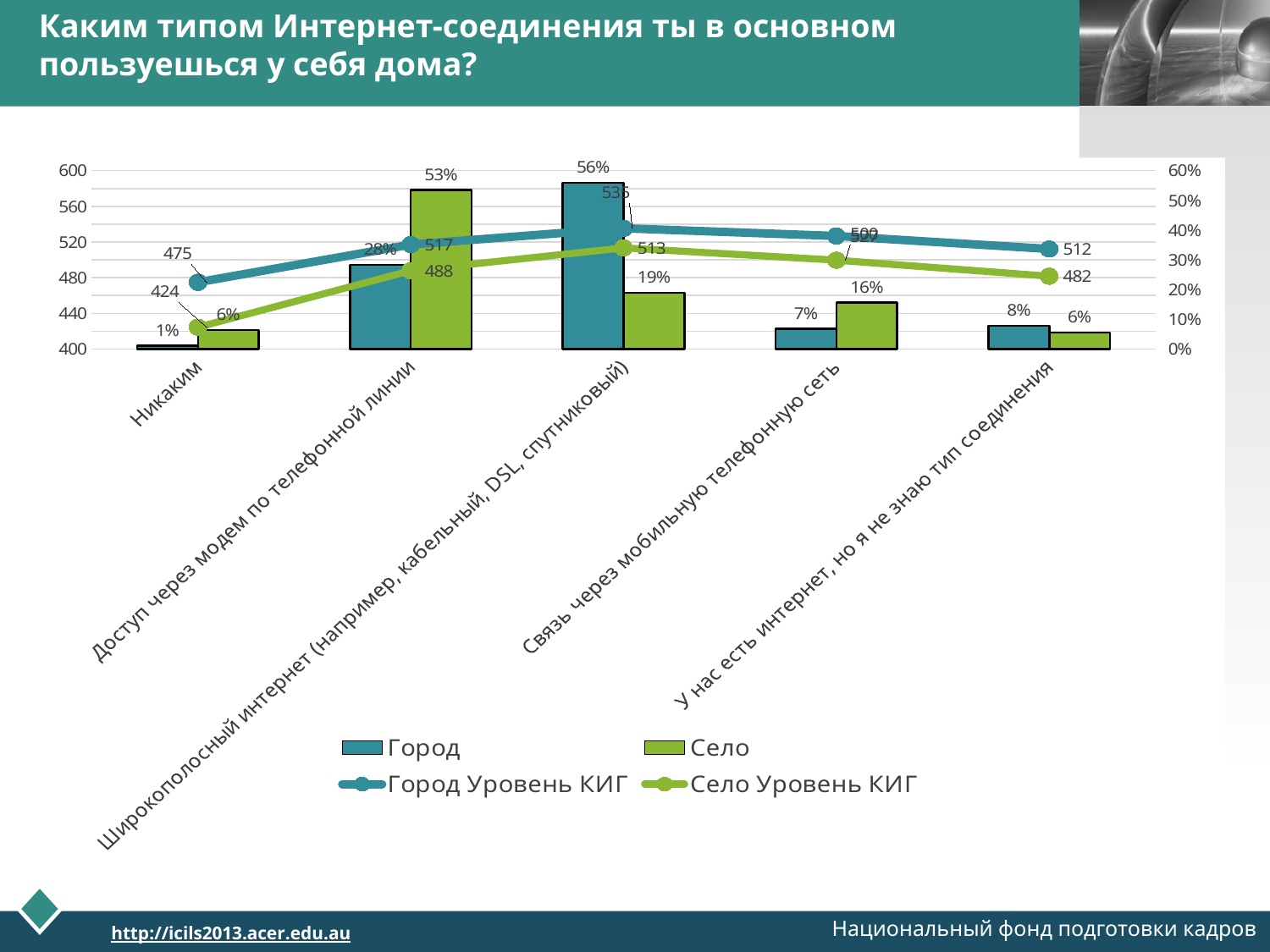
What percentage of Село respondents use Доступ через модем по телефонной линии? 53% What is the difference between the Город Уровень КИГ and Село Уровень КИГ values for Никаким? 51 How many series does the legend list? 4 What is the Село Уровень КИГ value for Широкополосный интернет (например, кабельный, DSL, спутниковый)? 513 What kind of chart is shown on the slide? Combination bar and line chart For Связь через мобильную телефонную сеть, which is larger: the Город bar or the Село bar? Село Which category has the lowest Город bar? Никаким Which category has the highest Село bar? Доступ через модем по телефонной линии What is the Город Уровень КИГ value for Никаким? 475 What percentage of Город respondents use Широкополосный интернет (например, кабельный, DSL, спутниковый)? 56% What is the difference between the Село and Город percentages for Никаким? 5% How many categories are shown on the x axis? 5